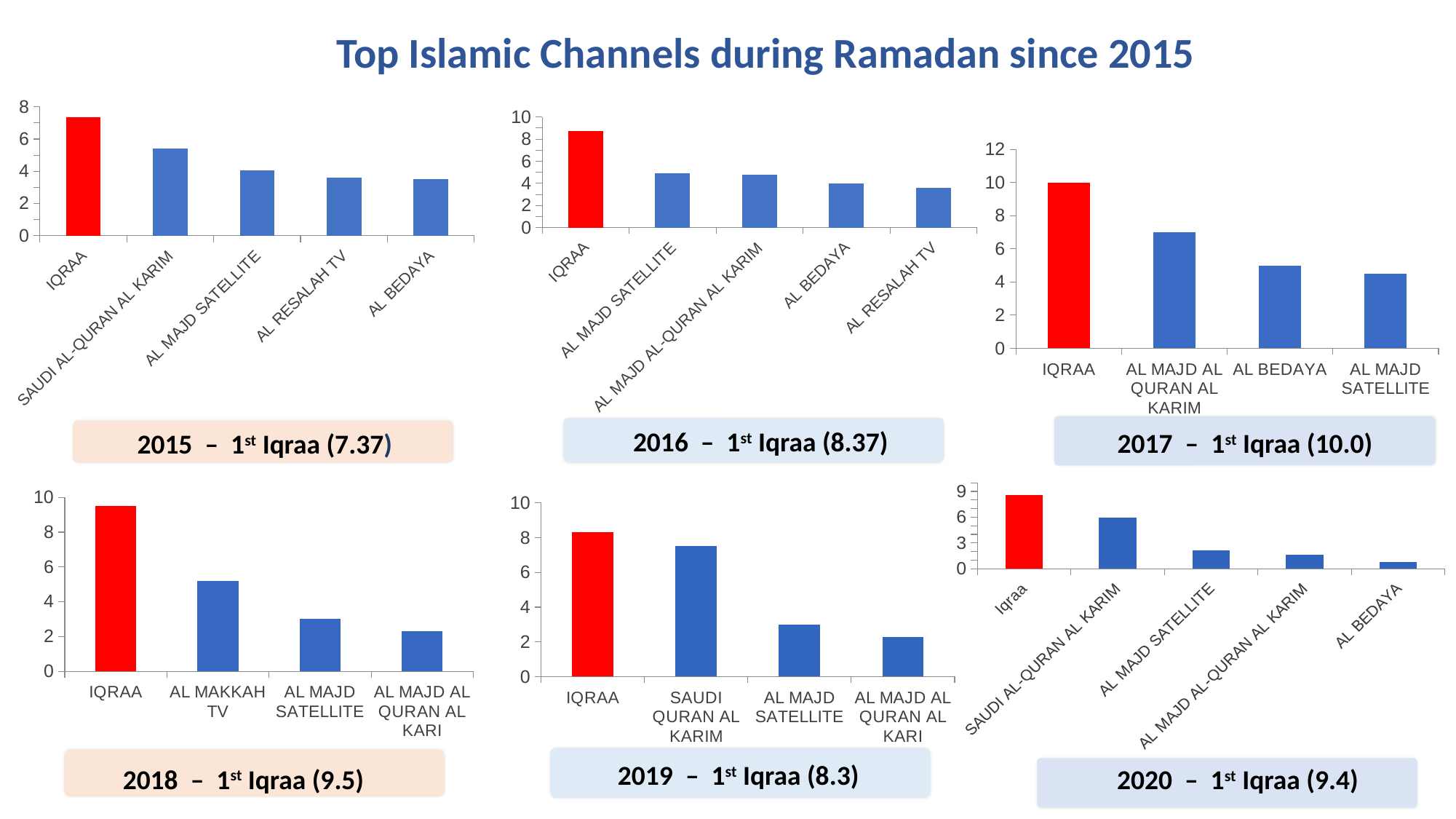
In the 2017 chart, which channel has the highest value? IQRAA According to the caption under the 2019 chart, what is Iqraa's value? 8.3 In the 2018 chart, what colour is the IQRAA bar? red In the 2019 chart, is the value for SAUDI QURAN AL KARIM greater or less than 6? greater In the 2018 chart, is the value for AL MAKKAH TV greater or less than 4? greater In the 2020 chart, which channel has the lowest value? AL BEDAYA In the 2020 chart, which is larger: SAUDI AL-QURAN AL KARIM or AL BEDAYA? SAUDI AL-QURAN AL KARIM According to the caption under the 2017 chart, what is Iqraa's value? 10.0 In the 2017 chart, is the value for AL MAJD SATELLITE greater or less than 6? less In the 2015 chart, how many channels are shown? 5 In the 2016 chart, do the values rise or fall from left to right? fall What kind of chart is the 2015 chart? bar chart